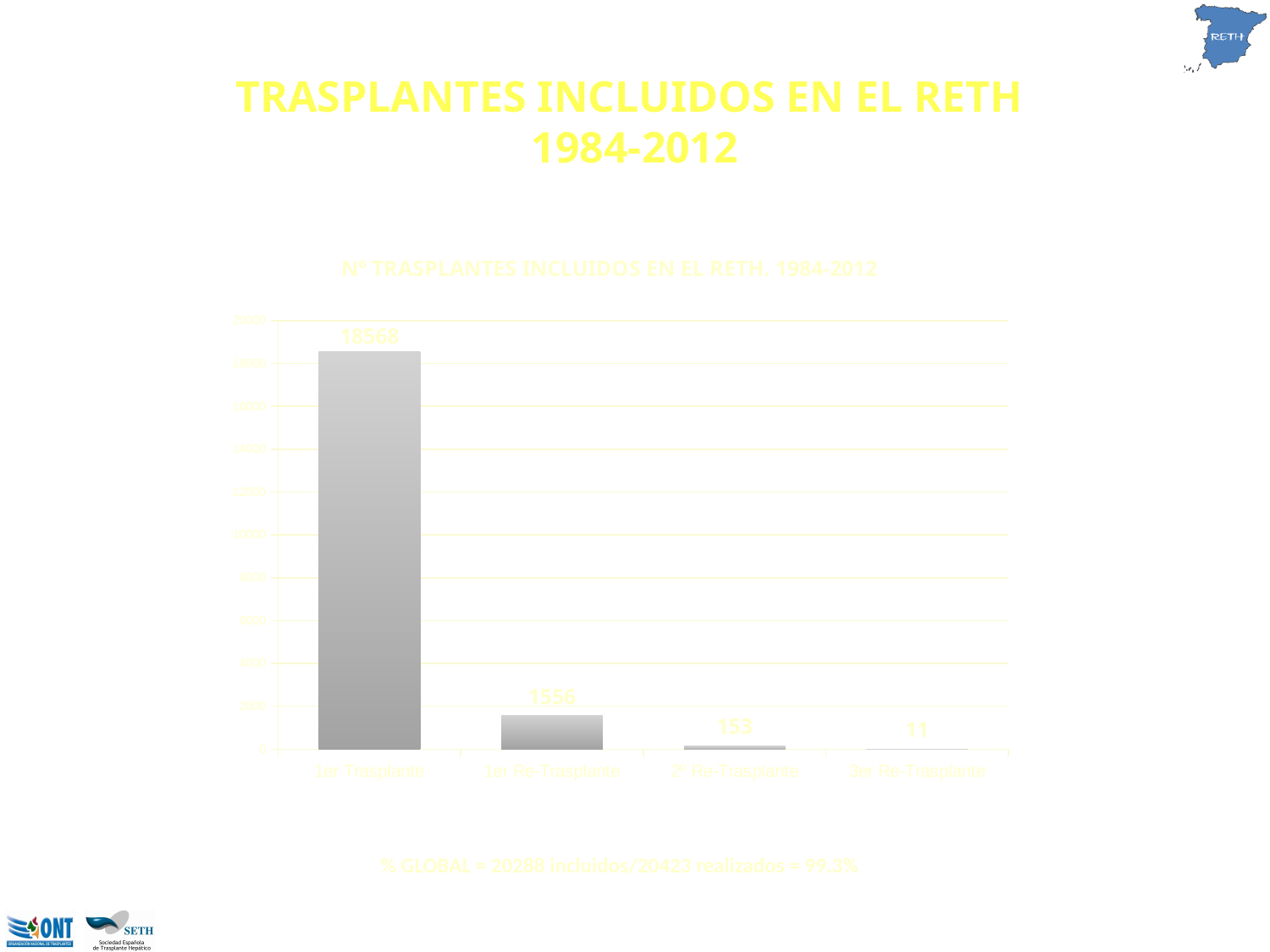
What is the value for 2º Re-Trasplante? 153 Which category has the highest value? 1er Trasplante What is the value for 3er Re-Trasplante? 11 What is the value for 1er Re-Trasplante? 1556 How many categories are shown on the x axis? 4 What is the title of the chart? Nº TRASPLANTES INCLUIDOS EN EL RETH. 1984-2012 What is the difference between the values for 1er Trasplante and 1er Re-Trasplante? 17012 What is the value for 1er Trasplante? 18568 What kind of chart is shown on the slide? bar chart What is the difference between the values for 2º Re-Trasplante and 3er Re-Trasplante? 142 Which category has the lowest value? 3er Re-Trasplante Which is larger, the value for 1er Re-Trasplante or the value for 2º Re-Trasplante? 1er Re-Trasplante